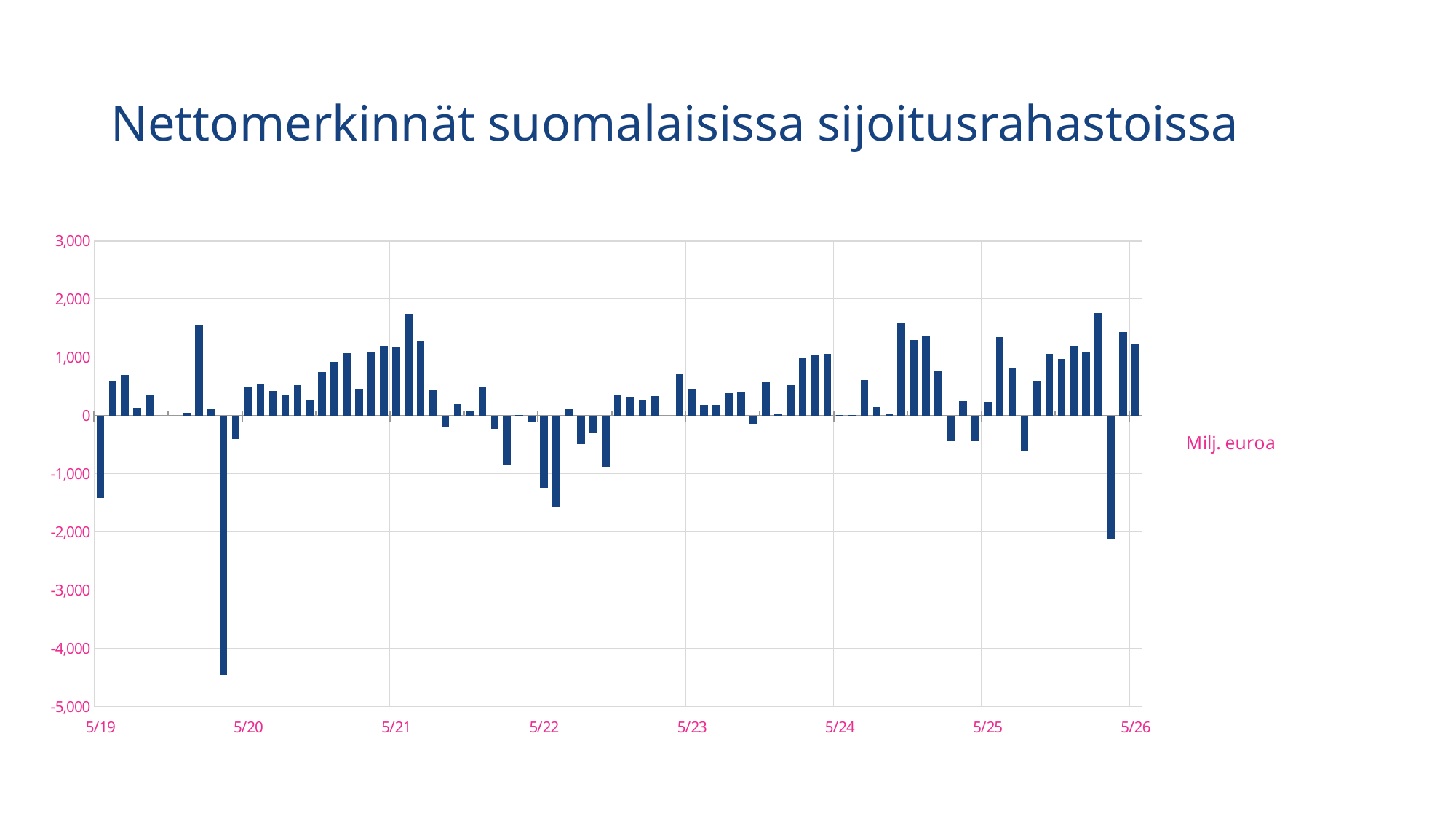
How many date labels are shown on the x axis? 8 What is the title of the chart? Nettomerkinnät suomalaisissa sijoitusrahastoissa Is the lowest value in the chart greater or less than -4,000? less Is the value for 5/21 greater or less than 1,000? greater Is the value for 5/23 greater or less than 0? greater Which is larger, the value for 5/21 or the value for 5/22? 5/21 What unit label is shown next to the chart? Milj. euroa What kind of chart is shown on the slide? bar chart